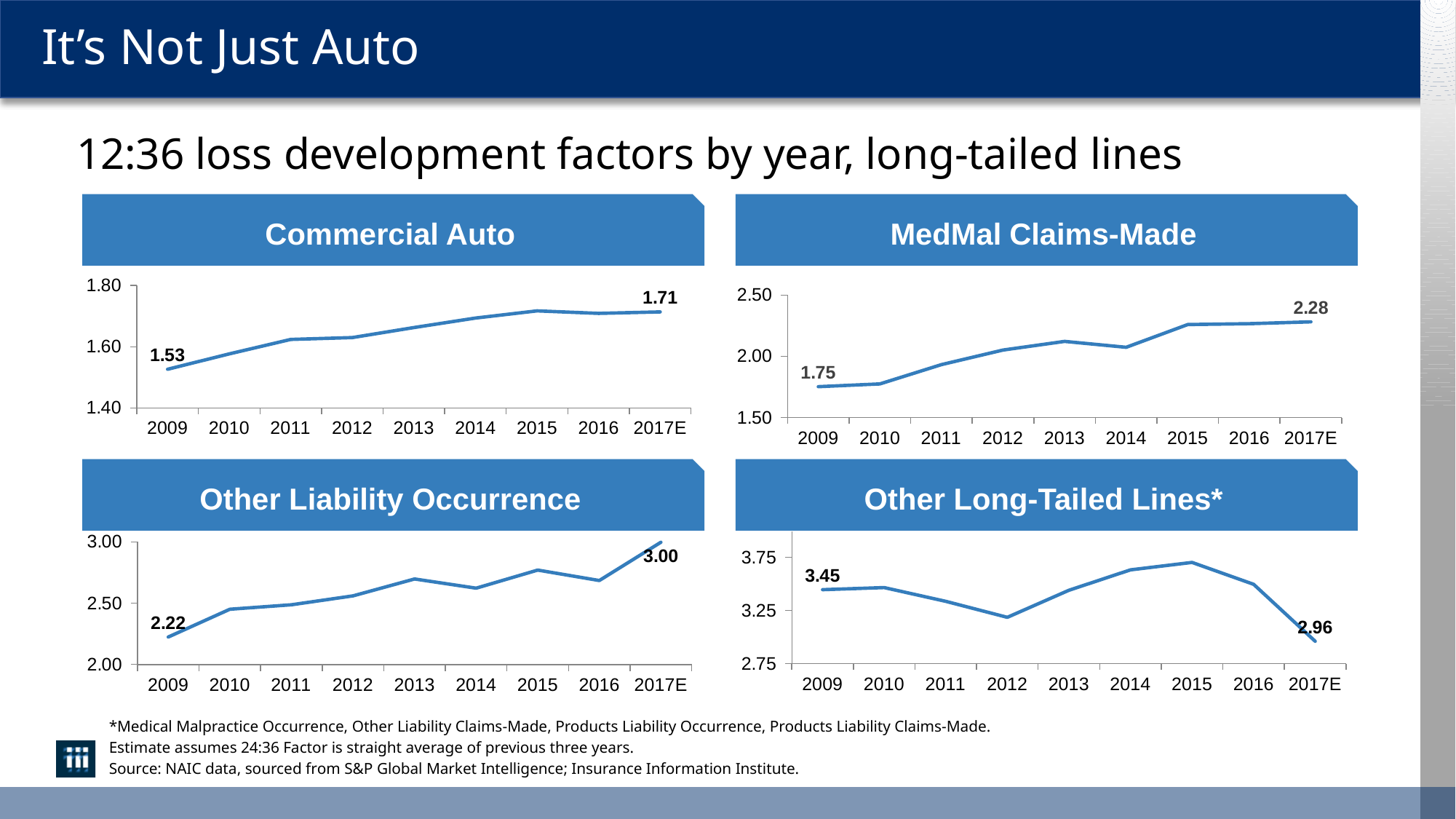
In the Commercial Auto chart, what is the difference between the 2017E value and the 2009 value? 0.18 How many years are plotted on the x axis of the Commercial Auto chart? 9 In the MedMal Claims-Made chart, what is the value for 2017E? 2.28 In the MedMal Claims-Made chart, what is the difference between the 2017E value and the 2009 value? 0.53 In the Commercial Auto chart, what is the value for 2017E? 1.71 In the Other Liability Occurrence chart, what is the value for 2009? 2.22 In the Other Long-Tailed Lines* chart, which is larger, the value for 2009 or the value for 2017E? 2009 In the MedMal Claims-Made chart, is the value for 2011 greater or less than 2.00? less In the Other Long-Tailed Lines* chart, what is the value for 2017E? 2.96 In the Commercial Auto chart, what is the value for 2009? 1.53 In the Other Liability Occurrence chart, is the value for 2013 greater or less than 2.50? greater What kind of chart is the Other Long-Tailed Lines* chart? line chart